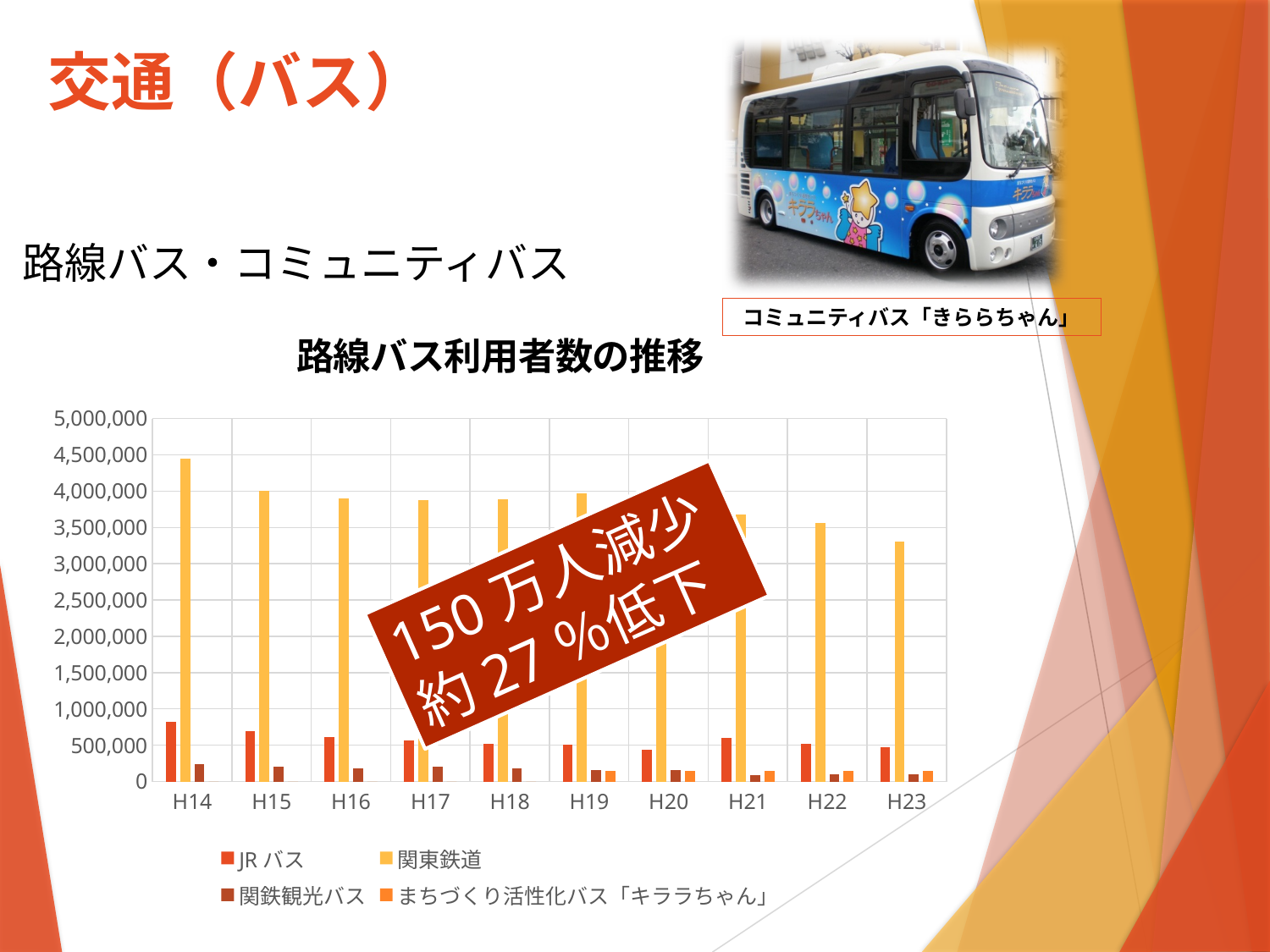
What kind of chart is shown on the slide? bar chart In which year is the value for 関東鉄道 highest? H14 Is the value for 関鉄観光バス in H14 greater or less than 500,000? less Is the value for 関東鉄道 in H23 greater or less than 3,500,000? less Which series is shown in yellow in the legend? 関東鉄道 Do the values for 関東鉄道 generally rise or fall from H14 to H23? fall What is the title of the chart? 路線バス利用者数の推移 How many years (categories) are shown on the x axis? 10 How many series does the legend list? 4 Which is larger: the value for 関東鉄道 in H14 or in H23? H14 Is the value for 関東鉄道 in H14 greater or less than 4,000,000? greater